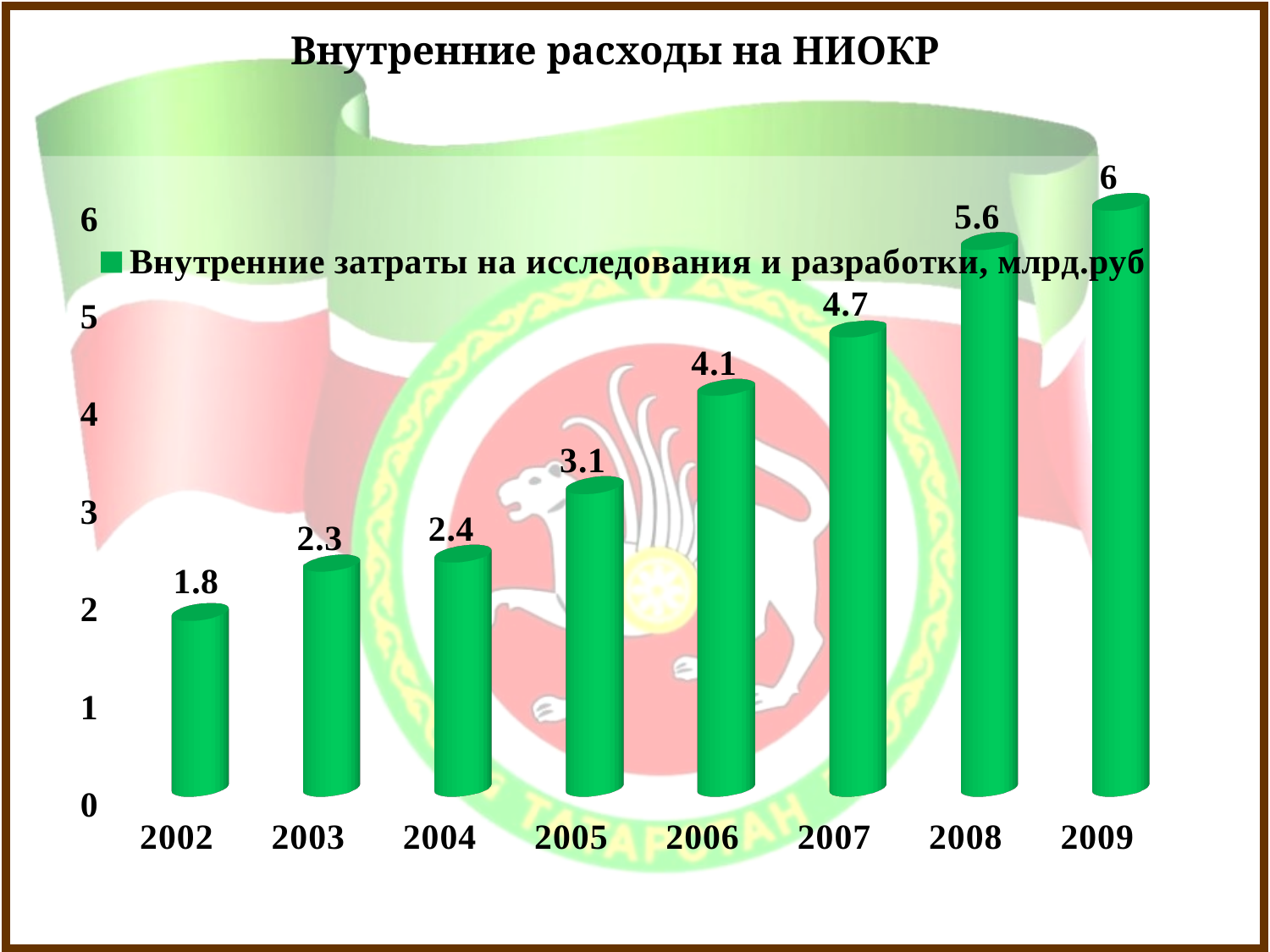
What is the value for 2006? 4.1 What is the value for 2002? 1.8 Do the values rise or fall from 2002 to 2009? rise Which is larger, the value for 2004 or the value for 2005? 2005 How many years are shown on the x axis? 8 What is the value for 2009? 6 Is the value for 2007 greater or less than 4? greater What is the difference between the values for 2008 and 2007? 0.9 How many series does the legend list? 1 What kind of chart is shown? bar chart Which year has the lowest value? 2002 Which year has the highest value? 2009